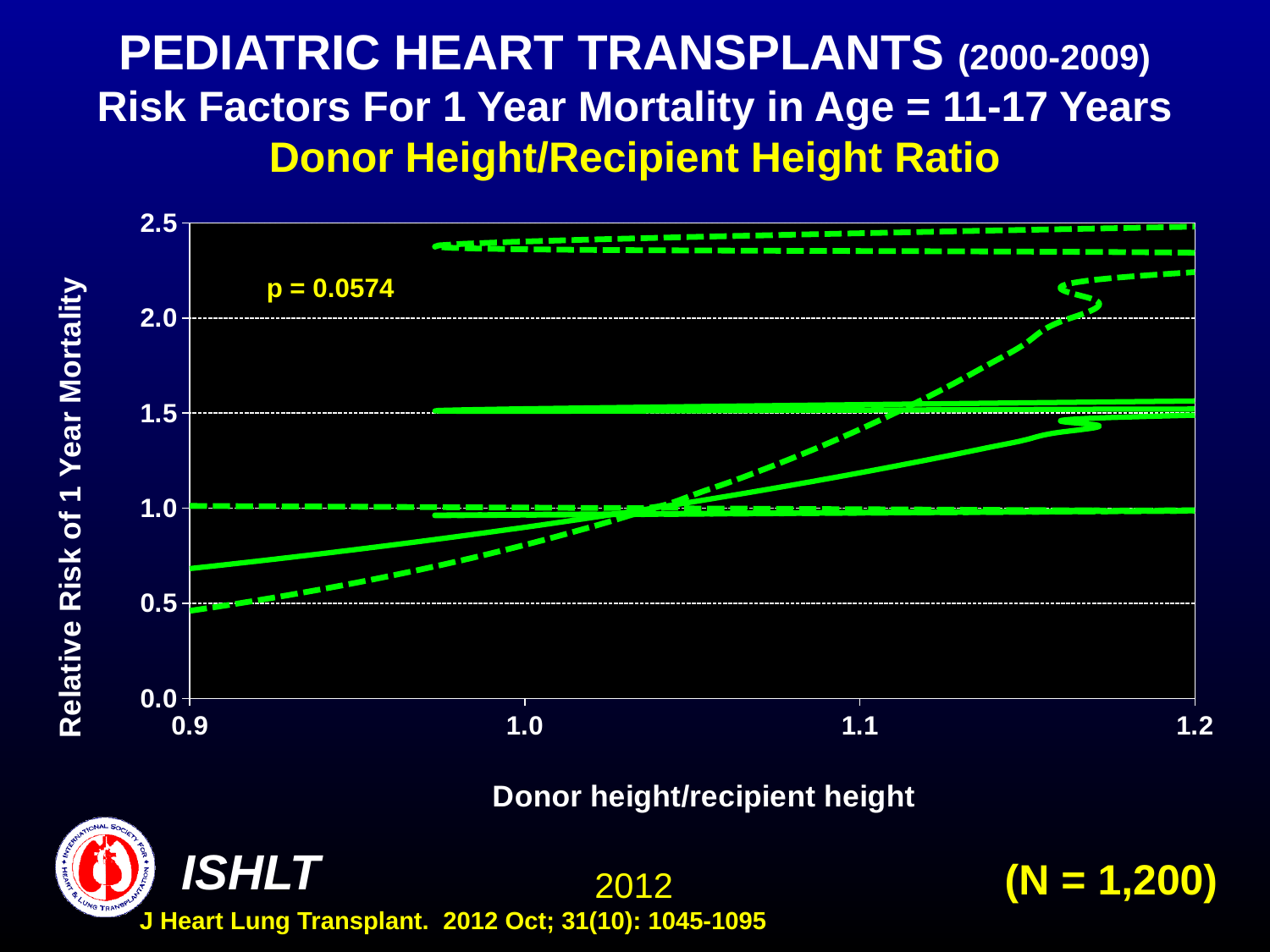
Does the solid relative risk line rise or fall as the donor height/recipient height ratio increases from 0.9 to 1.2? rise Is the solid relative risk line at a donor height/recipient height ratio of 1.1 greater or less than 1.0? greater Is the solid relative risk line at a donor height/recipient height ratio of 0.9 greater or less than 1.0? less Is the upper dashed line at a donor height/recipient height ratio of 1.2 greater or less than 2.0? greater What is the lowest value shown on the x axis? 0.9 What kind of chart is shown on the slide? line chart What is the highest value shown on the y axis? 2.5 What is the label of the y axis? Relative Risk of 1 Year Mortality